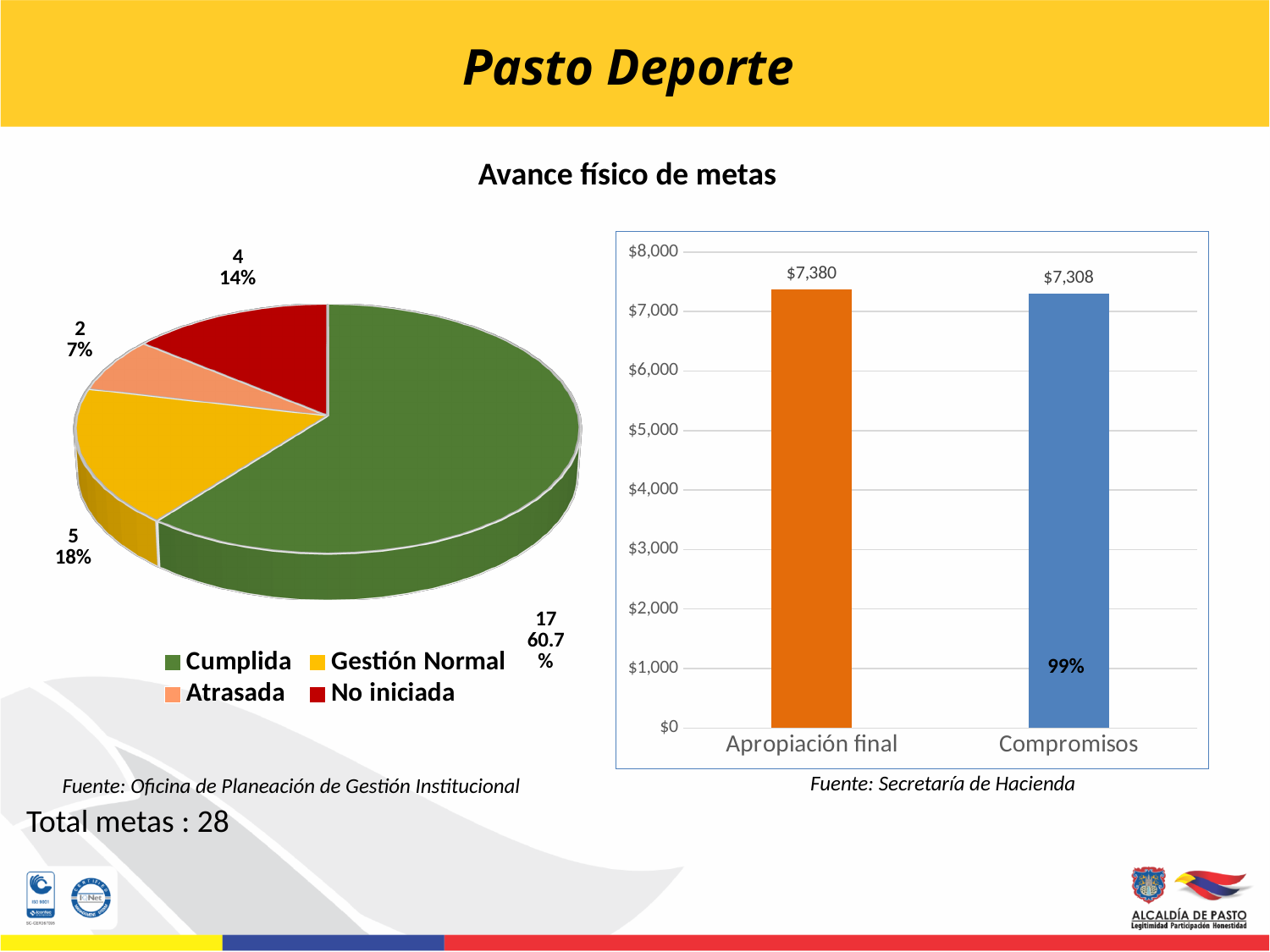
In the bar chart on the right, what is the value for Apropiación final? $7,380 In the pie chart on the left, how many metas are labelled Cumplida? 17 In the pie chart on the left, how many categories does the legend list? 4 In the pie chart on the left, what is the difference between the number of metas No iniciada and the number Atrasada? 2 In the pie chart on the left, which category has the largest slice? Cumplida In the pie chart on the left, what percentage share does the Cumplida slice have? 60.7% What kind of chart is shown on the right side of the slide? Bar chart In the bar chart on the right, what is the difference between Apropiación final and Compromisos? $72 In the bar chart on the right, what is the value for Compromisos? $7,308 In the bar chart on the right, what percentage label is printed on the Compromisos bar? 99% In the pie chart on the left, which category has the smallest slice? Atrasada In the pie chart on the left, what percentage share does the Gestión Normal slice have? 18%